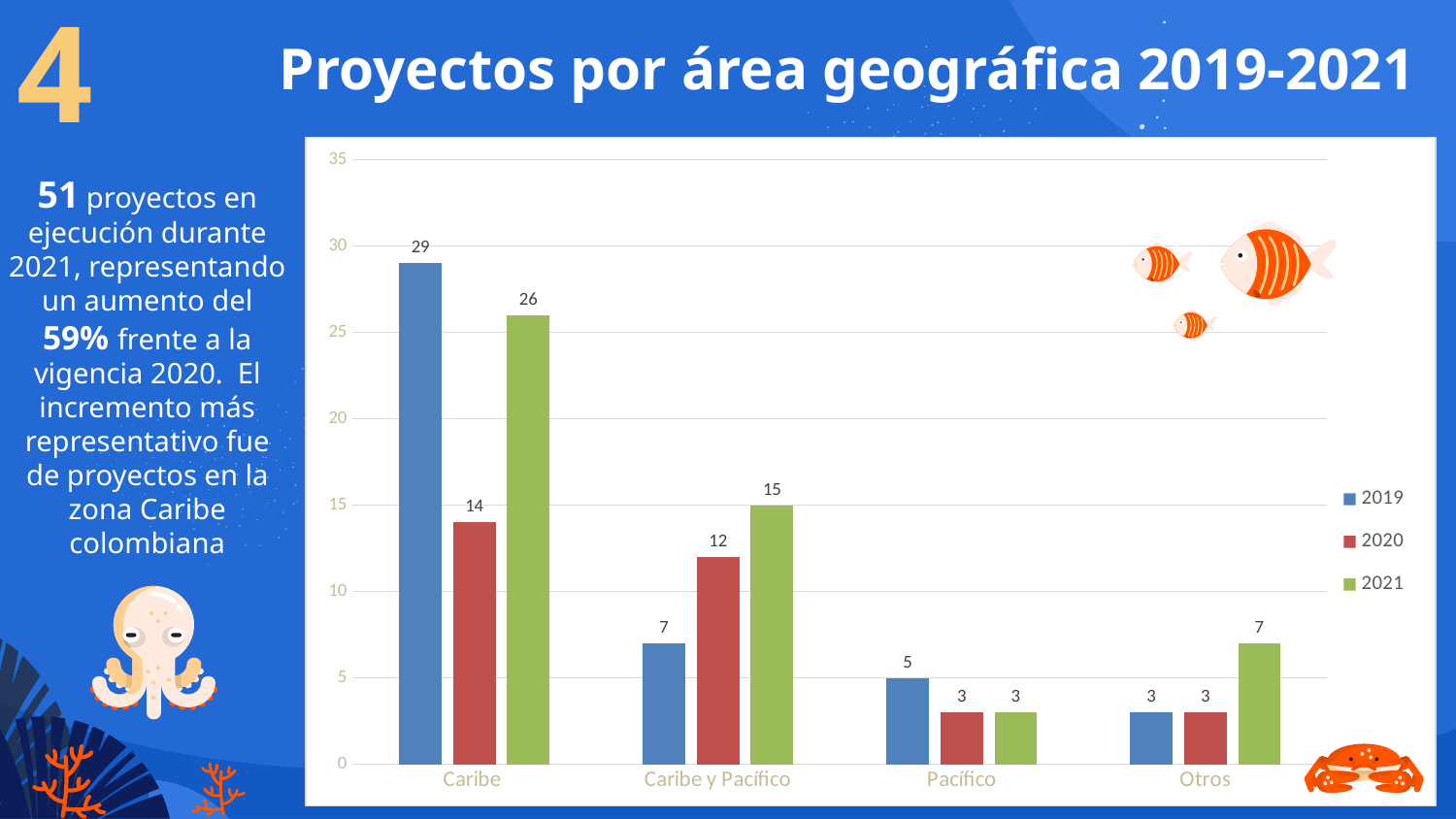
Which category has the lowest value in the 2019 series? Otros What is the value for Otros in 2021? 7 What is the value for Caribe y Pacífico in 2021? 15 What is the title of the chart? Proyectos por área geográfica 2019-2021 What is the value for Caribe in 2019? 29 Which category has the highest value in the 2020 series? Caribe What kind of chart is shown on the slide? bar chart What is the difference between the 2019 and 2020 values for Caribe? 15 How many categories are shown on the x axis? 4 Which is larger for Caribe y Pacífico: the 2020 value or the 2021 value? 2021 What is the value for Pacífico in 2019? 5 How many series does the legend list? 3